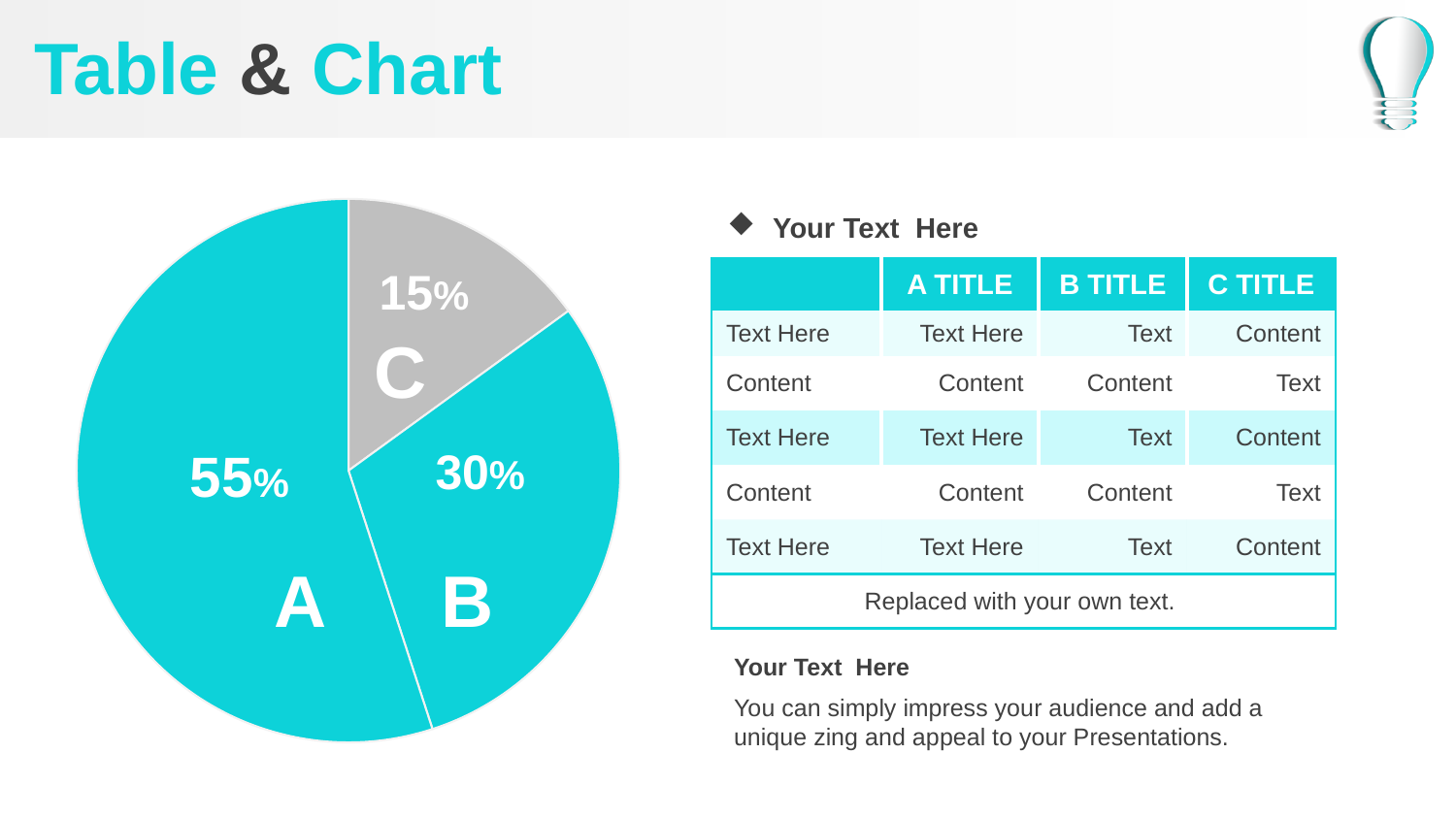
Which slice of the pie chart is the largest? A What is the difference in percentage points between slice A and slice B? 25 What is the combined share of slices A and B in the pie chart? 85% What percentage does slice C represent in the pie chart? 15% What percentage does slice B represent in the pie chart? 30% Which slice of the pie chart is coloured grey? C What percentage does slice A represent in the pie chart? 55% What kind of chart is shown on the left of the slide? pie chart Which is larger in the pie chart, slice B or slice C? B What is the difference in percentage points between slice B and slice C? 15 Which slice of the pie chart is the smallest? C How many slices does the pie chart have? 3